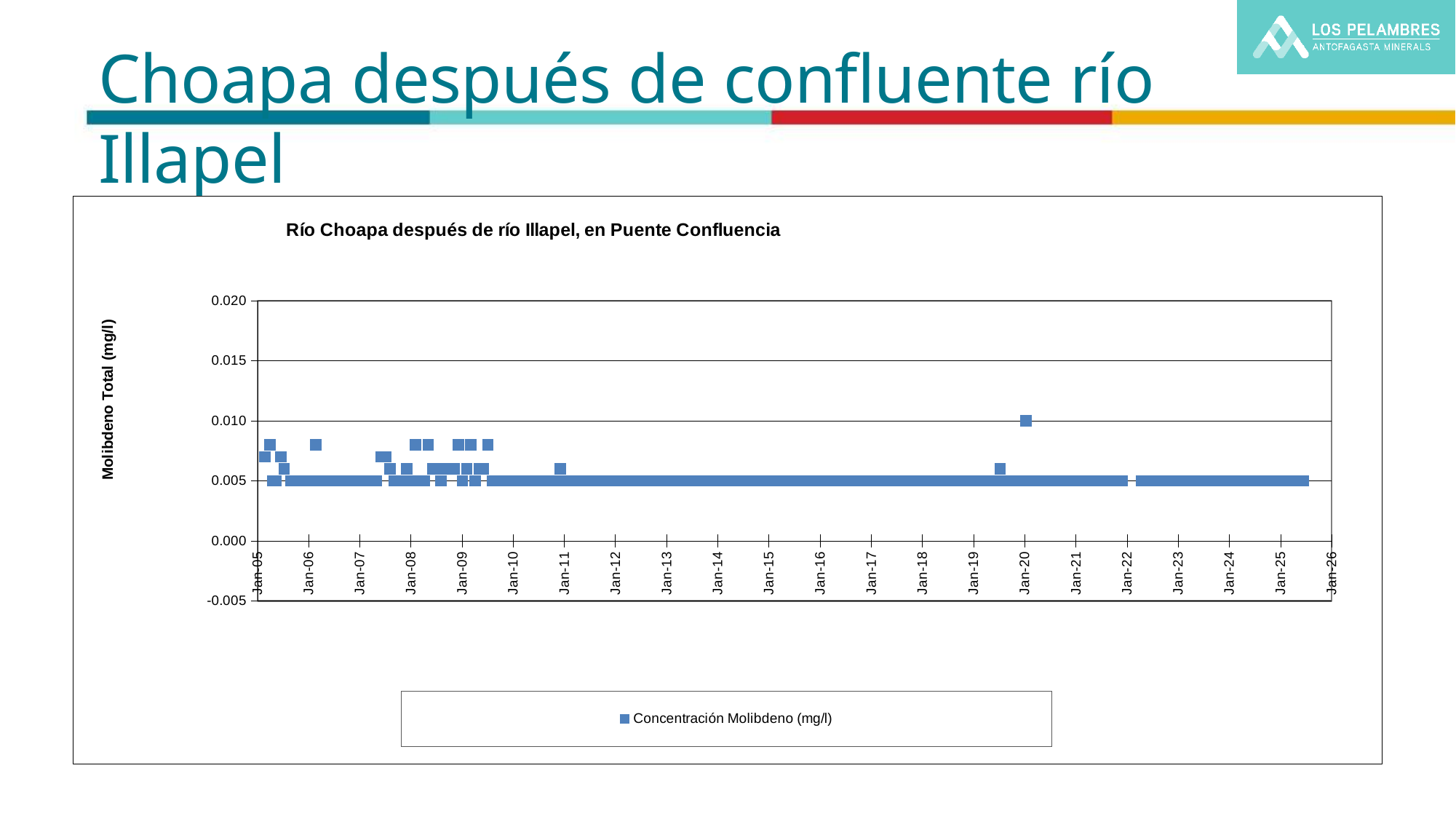
Is the highest plotted value on the chart greater or less than 0.005? greater What is the title of the chart? Río Choapa después de río Illapel, en Puente Confluencia Is the highest plotted value on the chart greater or less than 0.015? less Is the value plotted near Jan-11 greater or less than 0.010? less Do the plotted values rise, fall, or stay roughly flat from Jan-12 to Jan-19? stay roughly flat How many series does the legend list? 1 What kind of chart is shown on the slide? scatter chart What is the label of the y axis? Molibdeno Total (mg/l) On which y-axis tick value do most of the plotted points lie? 0.005